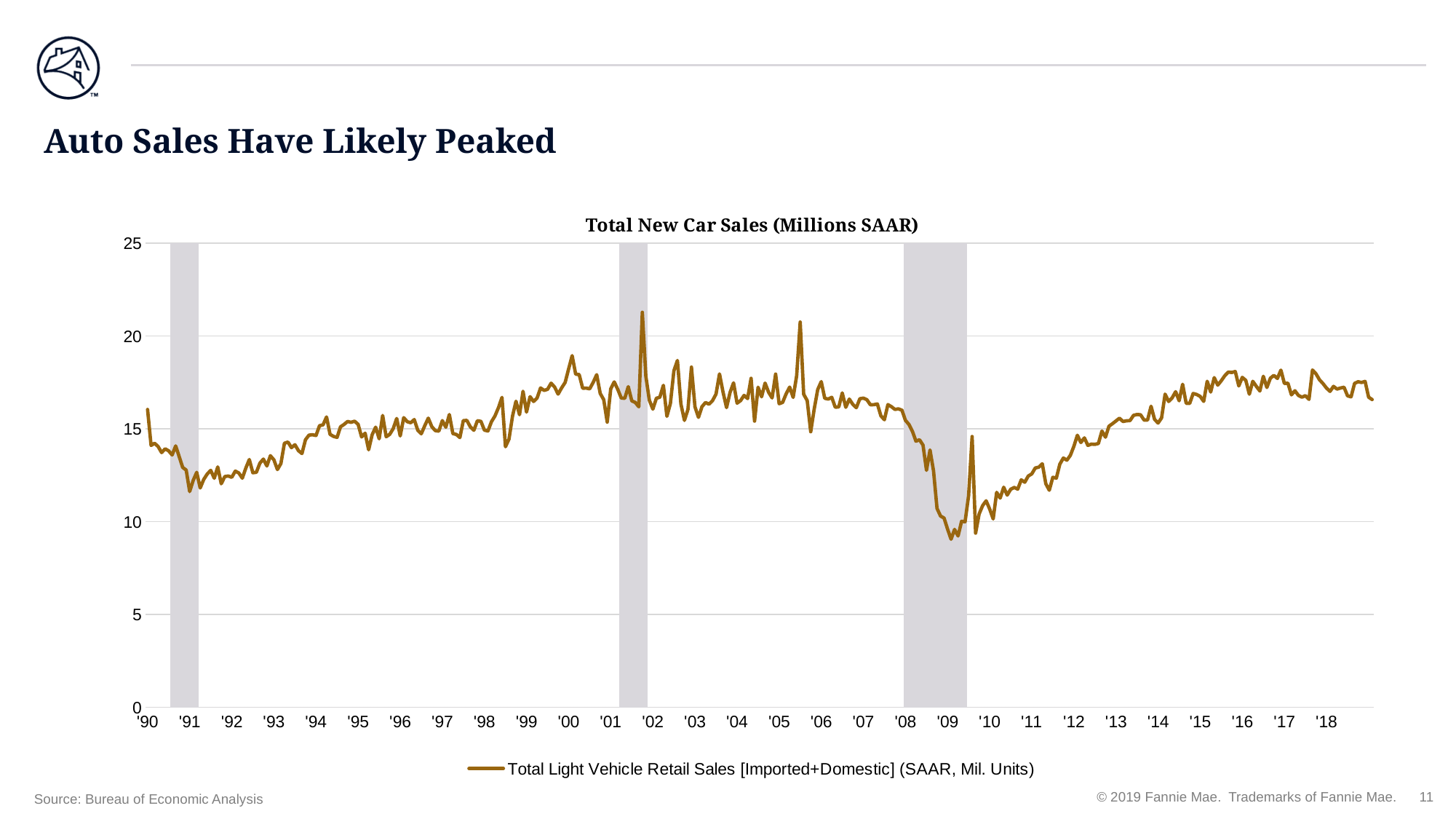
Is the value at the end of '18 greater or less than 15? greater What is the title of the chart? Total New Car Sales (Millions SAAR) Is the lowest value reached in '09 greater or less than 10? less How many series does the legend list? 1 What kind of chart is shown on the slide? line chart Is the spike in late '01 greater or less than 20? greater Do values rise or fall from '07 to '09? fall Do values rise or fall from '09 to '16? rise Which trough is lower, the one in '91 or the one in '09? '09 What is the legend entry for the plotted line? Total Light Vehicle Retail Sales [Imported+Domestic] (SAAR, Mil. Units)